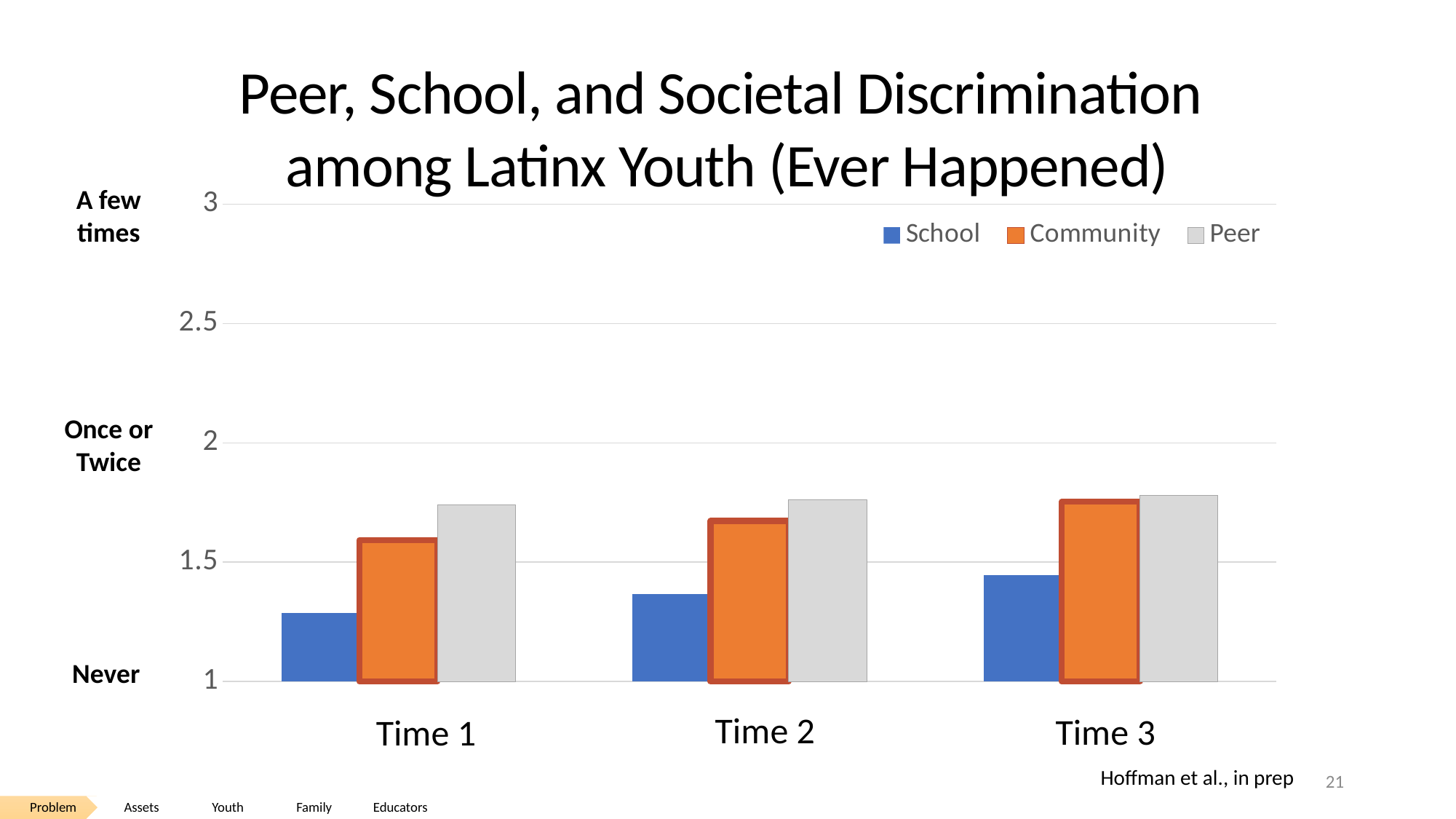
What kind of chart is shown on the slide? bar chart Which series has the highest value at Time 1? Peer Is the value for Community at Time 2 greater or less than 1.5? greater Which series is shown in orange in the legend? Community Which series has the lowest value at Time 1? School At Time 2, which is larger, School or Community? Community Is the value for Peer at Time 3 greater or less than 2? less Is the value for School at Time 1 greater or less than 1.5? less Do the School values rise or fall from Time 1 to Time 3? rise Which bar is the lowest in the whole chart? School at Time 1 How many series does the legend list? 3 How many time points are shown on the x axis? 3